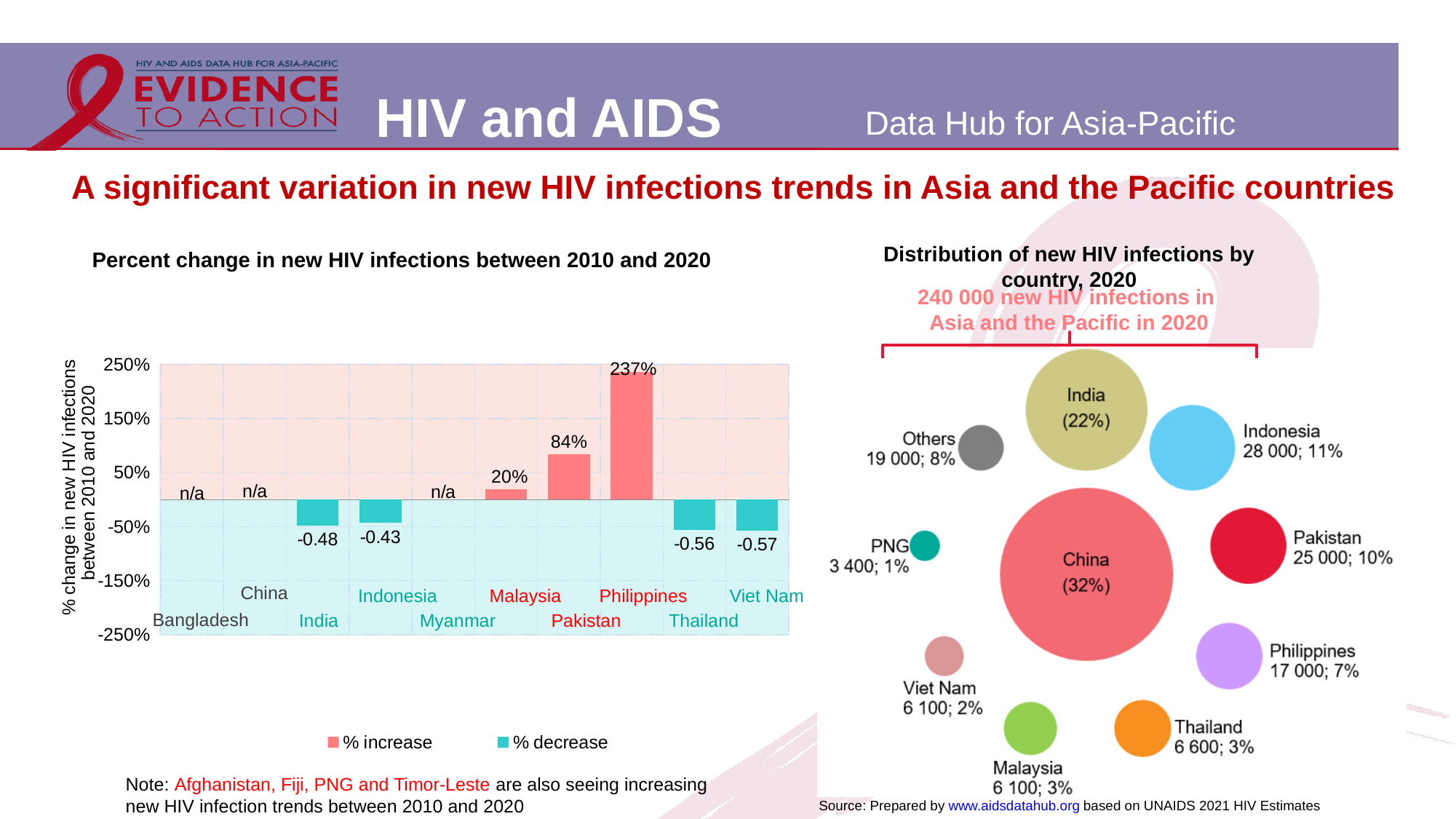
In the bar chart 'Percent change in new HIV infections between 2010 and 2020', what value is labelled for Viet Nam? -0.57 In the chart 'Distribution of new HIV infections by country, 2020', how many new HIV infections are shown for Indonesia? 28 000 In the bar chart 'Percent change in new HIV infections between 2010 and 2020', what is the value shown for Pakistan? 84% In the bar chart 'Percent change in new HIV infections between 2010 and 2020', what is the value for the Philippines? 237% In the bar chart 'Percent change in new HIV infections between 2010 and 2020', which country has the highest percent change? Philippines In the chart 'Distribution of new HIV infections by country, 2020', which has more new HIV infections, Pakistan or the Philippines? Pakistan In the bar chart 'Percent change in new HIV infections between 2010 and 2020', which country has the lowest labelled value? Viet Nam In the bar chart 'Percent change in new HIV infections between 2010 and 2020', how many series does the legend list? 2 What kind of chart is 'Percent change in new HIV infections between 2010 and 2020'? Bar chart In the chart 'Distribution of new HIV infections by country, 2020', what share of new HIV infections does China account for? 32% In the bar chart 'Percent change in new HIV infections between 2010 and 2020', how many countries are shown on the x axis? 10 In the bar chart 'Percent change in new HIV infections between 2010 and 2020', is the value for Pakistan greater or less than 50%? greater